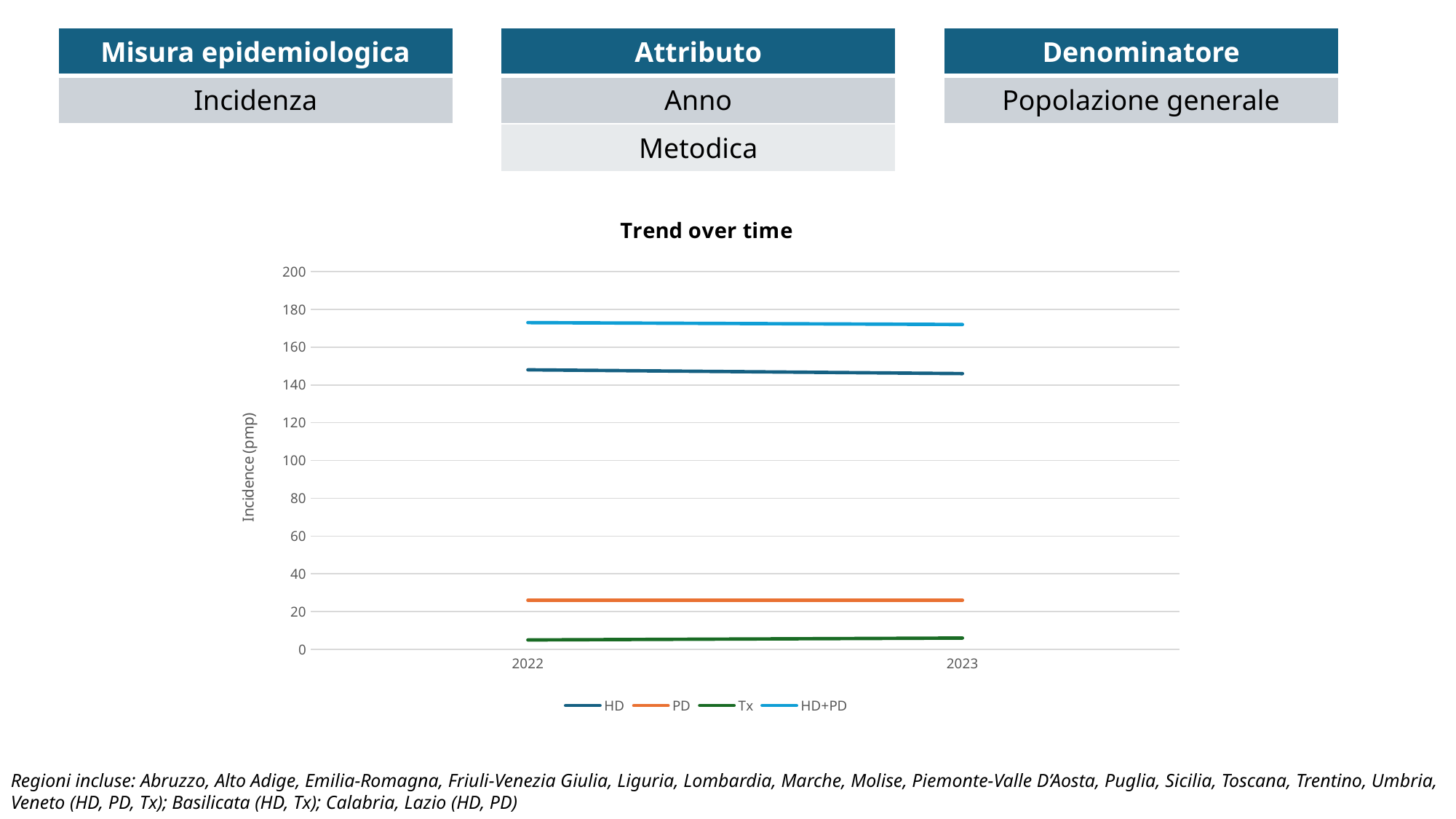
Is the value for Tx in 2023 greater or less than 20? less What kind of chart is shown on the slide? line chart Which series has the highest values in the chart? HD+PD Is the value for HD+PD in 2022 greater or less than 160? greater Is the value for HD in 2023 greater or less than 160? less How many years are shown on the x axis of the chart? 2 Which series has the lowest values in the chart? Tx What is the title of the chart? Trend over time Which is larger in 2023, the value for PD or the value for Tx? PD How many series does the legend of the chart list? 4 What is the label of the y axis of the chart? Incidence (pmp)